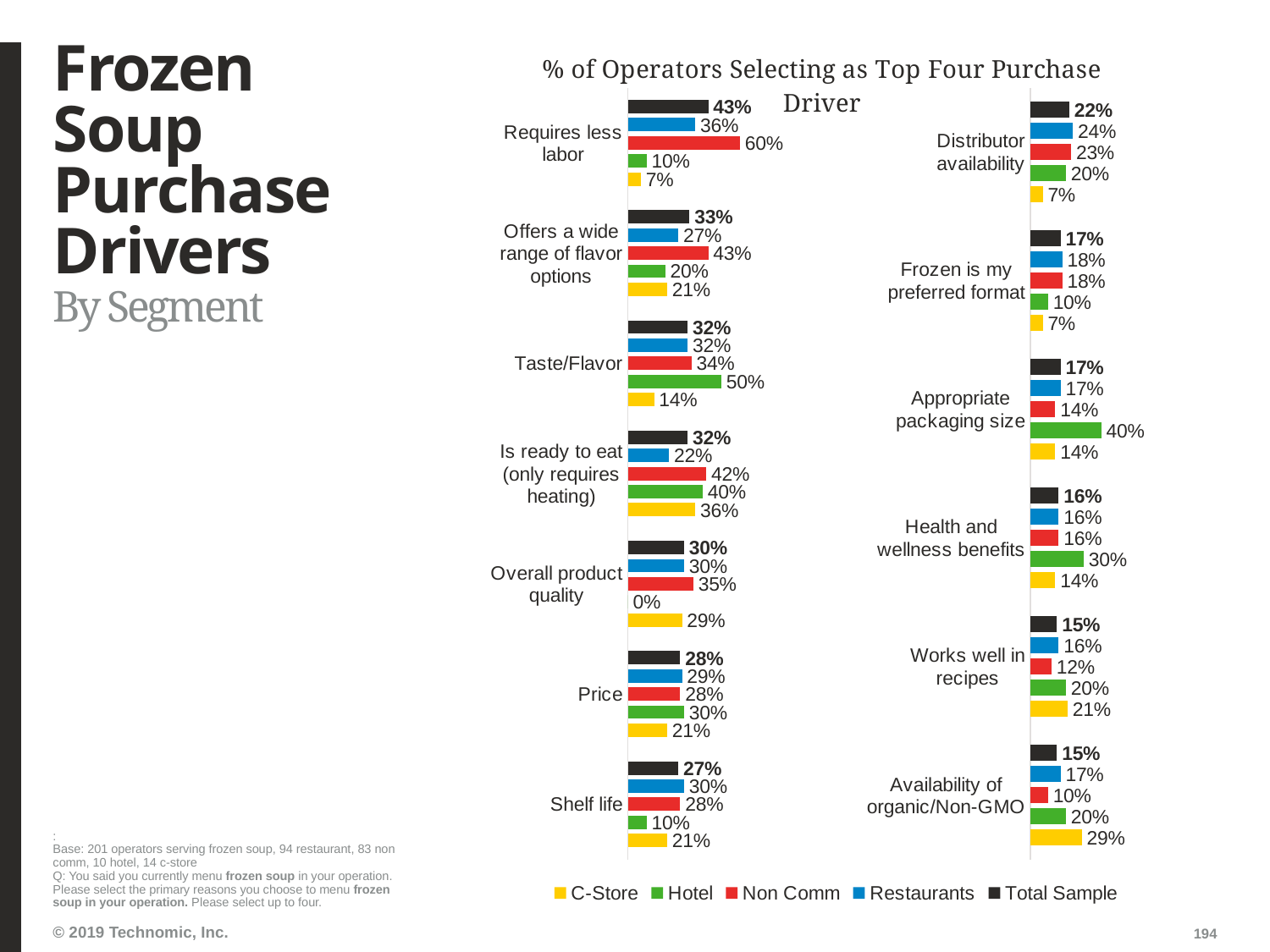
On the right chart, what is the Hotel value for Appropriate packaging size? 40% On the left chart, which category has the highest Total Sample value? Requires less labor On the left chart, what is the Hotel value for Taste/Flavor? 50% On the left chart, what is the Non Comm value for Requires less labor? 60% How many series does the legend list? 5 On the left chart, what is the difference between the Non Comm and C-Store values for Requires less labor? 53% On the left chart, which category has the lowest Hotel value? Overall product quality What kind of chart is used on this slide? Bar chart Which colour represents Non Comm in the legend? Red How many categories are shown on the right chart? 6 On the right chart, what is the C-Store value for Availability of organic/Non-GMO? 29% On the right chart, which is larger for Works well in recipes: the Restaurants value or the Hotel value? Hotel